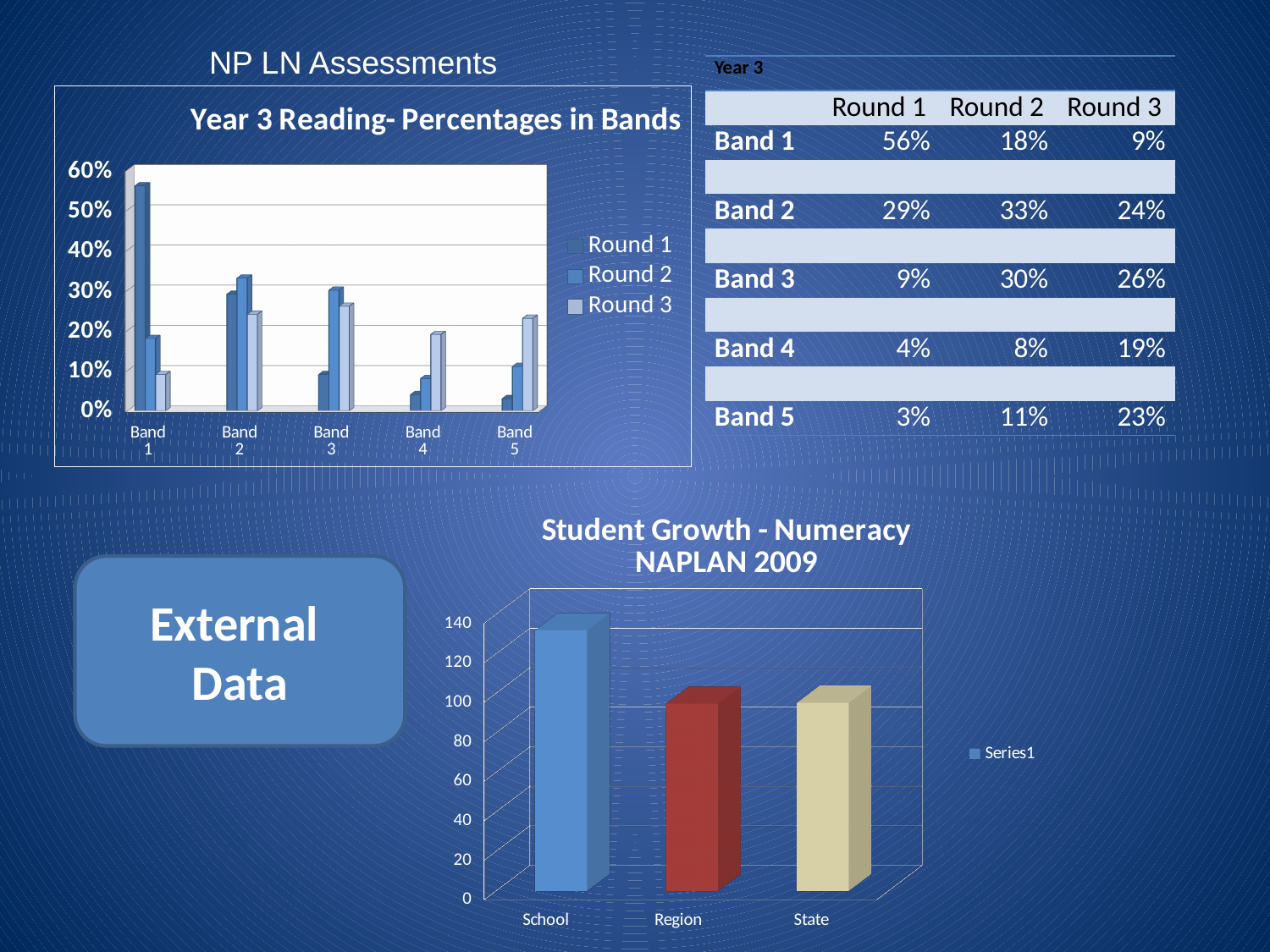
According to the Year 3 table on the slide, what is the Round 2 value for Band 3? 30% How many series does the legend of the 'Year 3 Reading- Percentages in Bands' chart list? 3 In the 'Year 3 Reading- Percentages in Bands' chart, is the Round 1 value for Band 1 greater or less than 50%? greater In the 'Year 3 Reading- Percentages in Bands' chart, which is larger for Band 4: Round 1 or Round 3? Round 3 What type of chart is the 'Year 3 Reading- Percentages in Bands' chart? bar chart In the 'Year 3 Reading- Percentages in Bands' chart, is the Round 3 value for Band 1 greater or less than 10%? less In the 'Student Growth - Numeracy NAPLAN 2009' chart, which category has the highest value? School How many bands are shown on the x axis of the 'Year 3 Reading- Percentages in Bands' chart? 5 What type of chart is the 'Student Growth - Numeracy NAPLAN 2009' chart? bar chart According to the Year 3 table on the slide, what is the difference between the Round 1 and Round 3 values for Band 1? 47% In the 'Student Growth - Numeracy NAPLAN 2009' chart, is the value for School greater or less than 120? greater In the 'Year 3 Reading- Percentages in Bands' chart, which band has the highest Round 1 value? Band 1